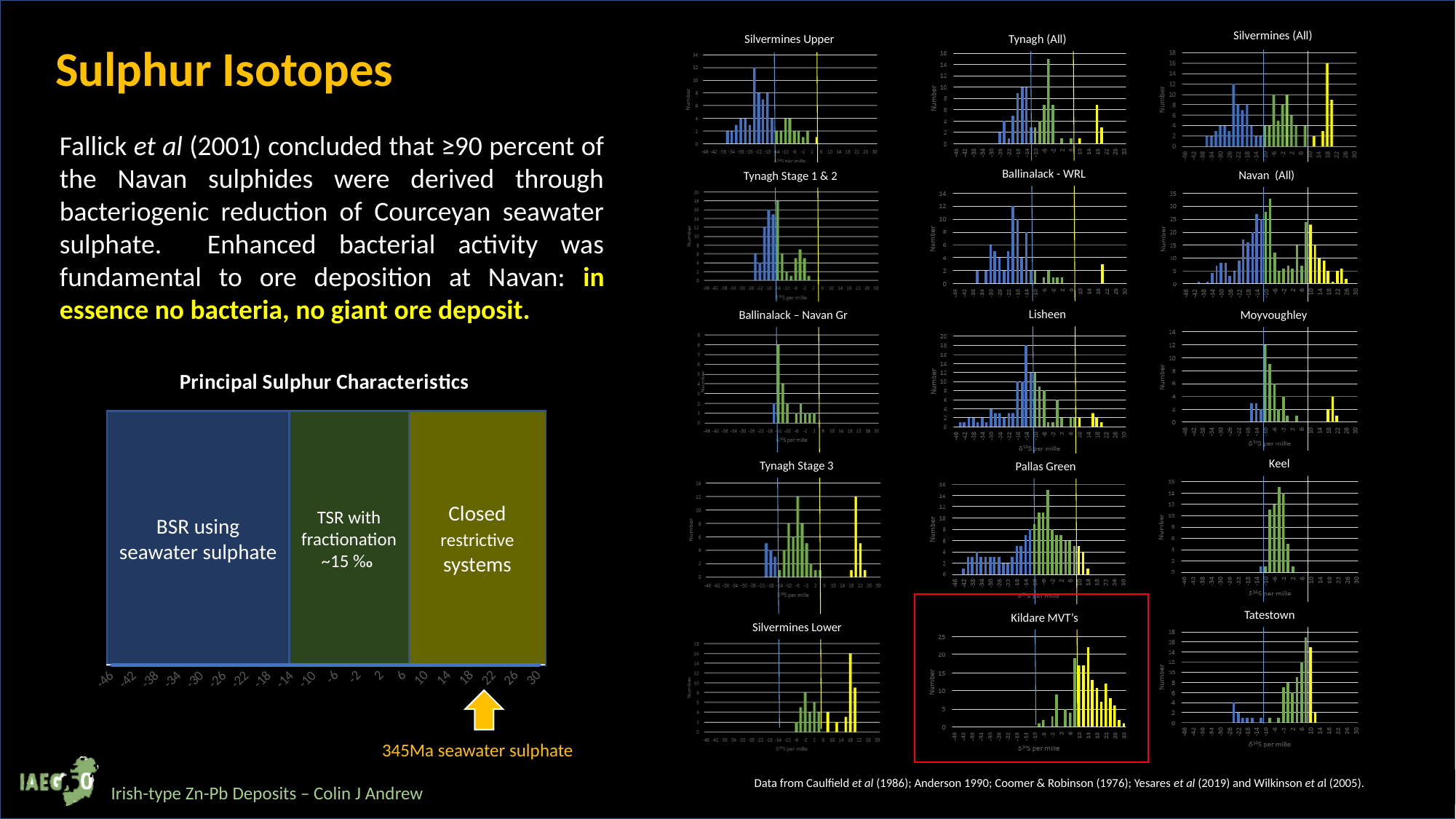
In the Kildare MVT's chart, is the tallest bar greater or less than 25? less What kind of chart is the Kildare MVT's chart? bar chart In the Navan (All) chart, is the tallest bar greater or less than 25? greater In the Tynagh Stage 1 & 2 chart, is the tallest bar greater or less than 15? greater Which chart on the slide is outlined with a red box? Kildare MVT's How many small histogram charts are shown on the right side of the slide? 15 Which chart has the taller tallest bar, Kildare MVT's or Moyvoughley? Kildare MVT's